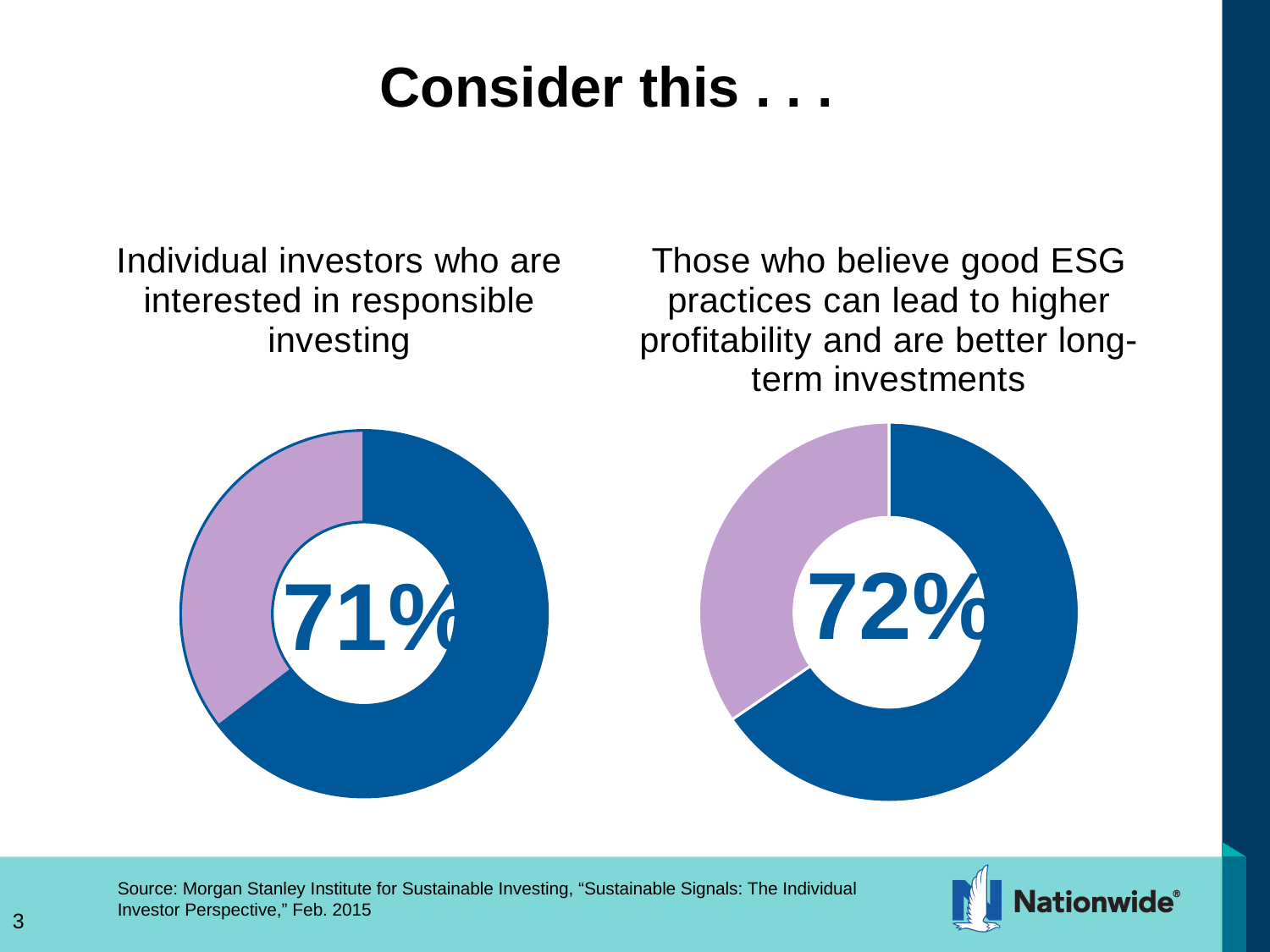
What kind of chart is used on this slide to show the 71% and 72% figures? donut (pie) chart In the left donut chart, is the highlighted 71% share greater or less than half of the ring? greater What colour is the segment representing the 72% share in the right donut chart? blue Which chart shows the larger percentage, the left one (interested in responsible investing) or the right one (believe good ESG practices lead to higher profitability)? the right one In the left donut chart, what percentage of individual investors are interested in responsible investing? 71% How many donut charts are shown on the slide? 2 In the right donut chart, what percentage believe good ESG practices can lead to higher profitability and are better long-term investments? 72% What is the difference in percentage points between the value in the right donut chart (72%) and the value in the left donut chart (71%)? 1 percentage point What is the title of the slide containing the two donut charts? Consider this . . .